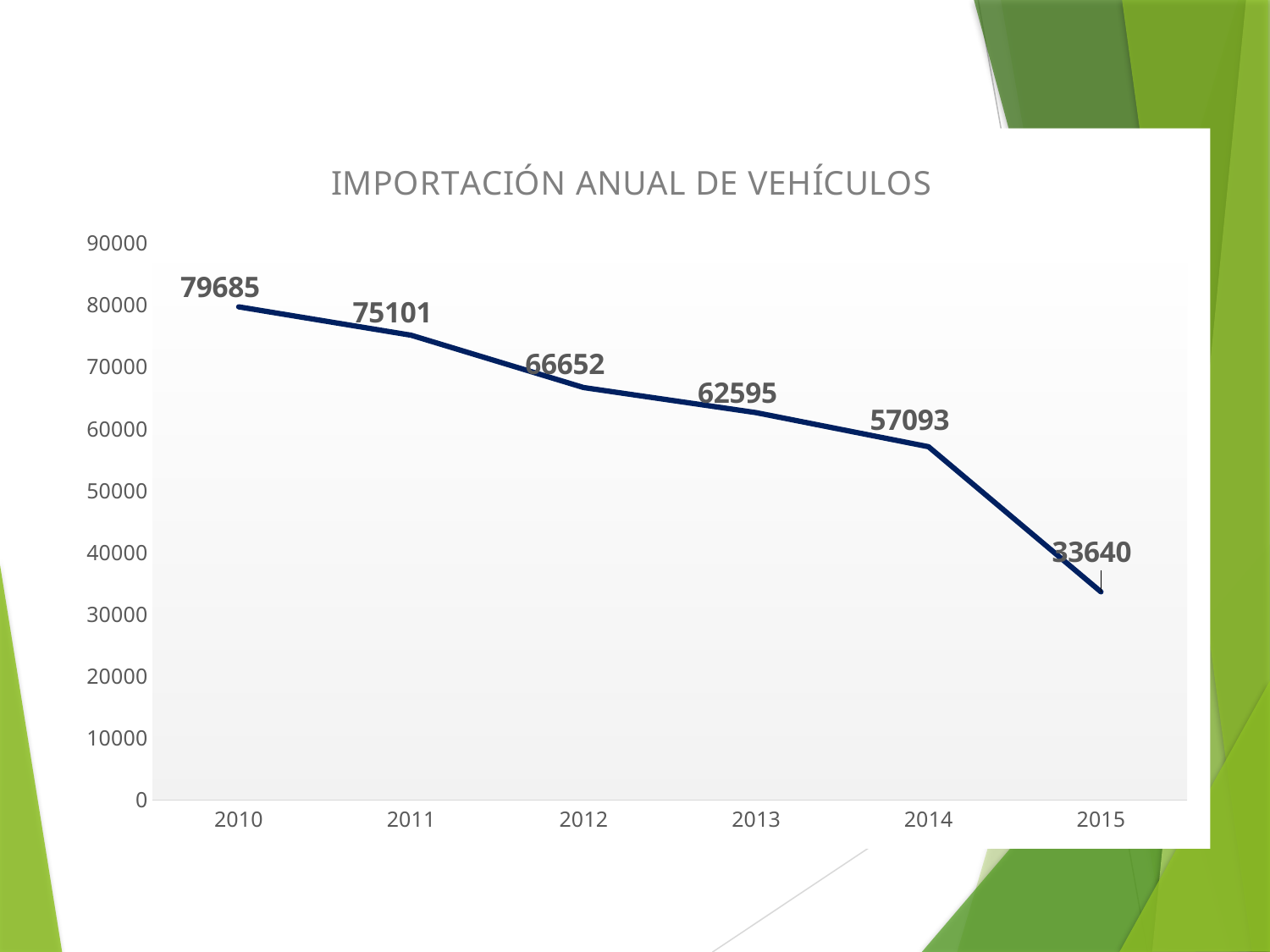
How many years are plotted on the chart? 6 What is the value for 2013? 62595 Is the value for 2014 greater or less than 60000? less Do the values rise or fall from 2010 to 2015? fall What is the value for 2010? 79685 What kind of chart is shown? line chart Which is larger, the value for 2012 or the value for 2013? 2012 Which year has the lowest value? 2015 Which year has the highest value? 2010 What is the difference between the values for 2010 and 2011? 4584 What is the difference between the values for 2014 and 2015? 23453 What is the value for 2015? 33640